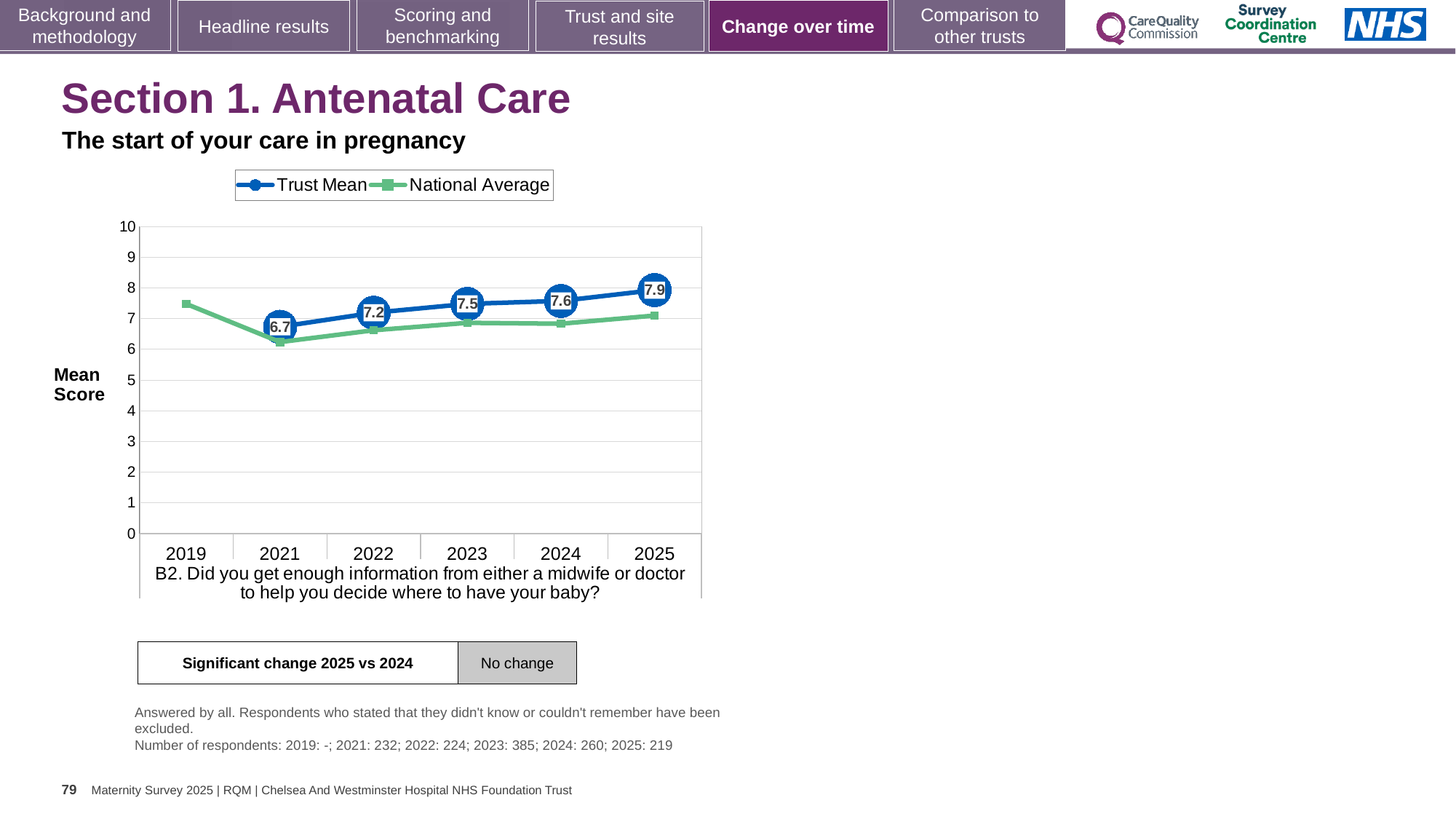
How many series does the legend list? 2 How many years are shown on the x axis of the chart? 6 What is the Trust Mean for 2023? 7.5 In which year is the Trust Mean highest? 2025 What is the difference between the Trust Mean in 2025 and in 2021? 1.2 Is the National Average for 2019 greater or less than 7? greater What is the Trust Mean for 2021? 6.7 What is the Trust Mean for 2025? 7.9 In which year is the Trust Mean lowest? 2021 What kind of chart is shown on the slide? Line chart Which is larger, the Trust Mean in 2022 or in 2024? 2024 Is the National Average for 2021 greater or less than 7? less